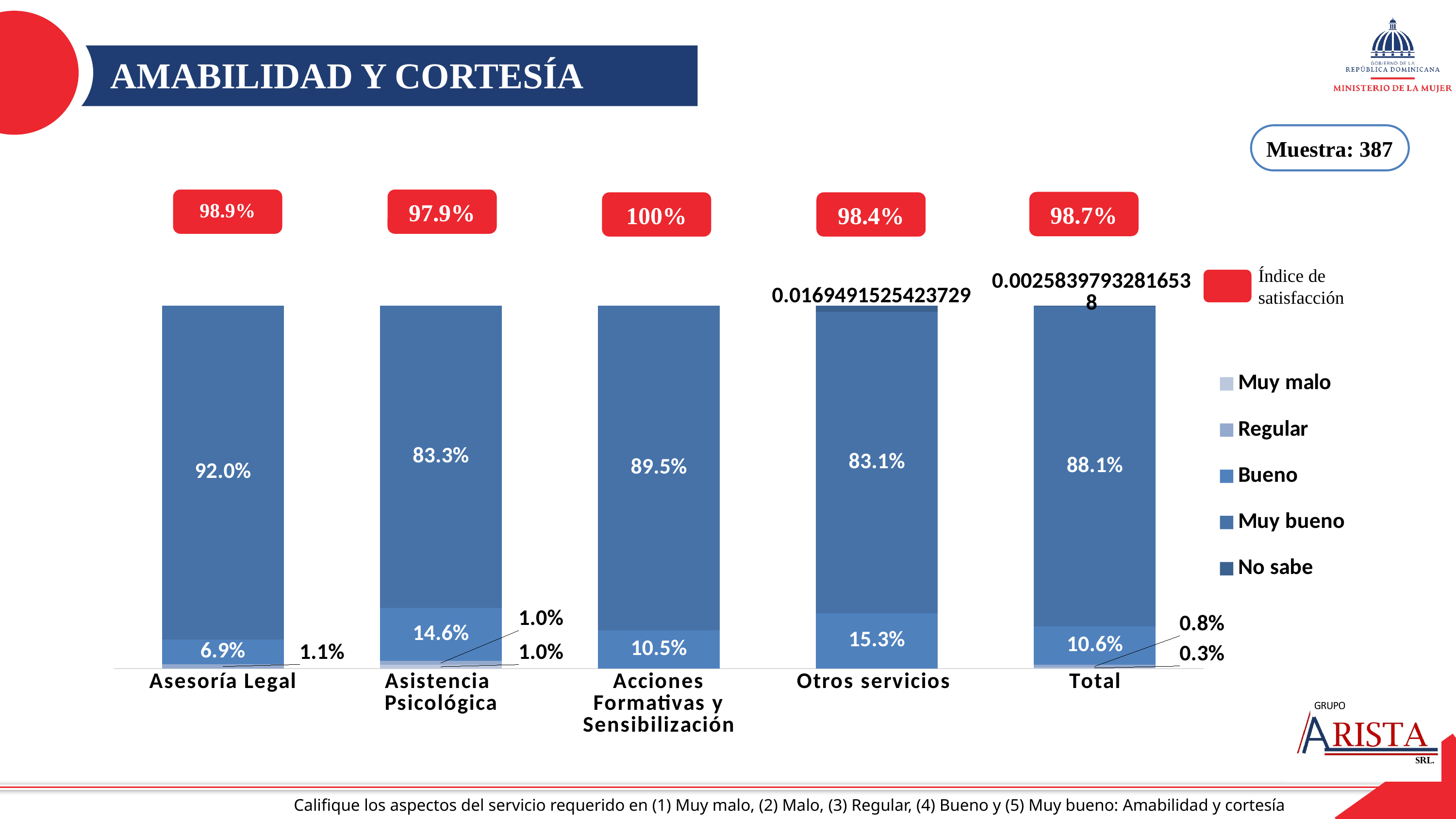
What sample size (Muestra) is shown on the slide? 387 What is the Índice de satisfacción shown for Acciones Formativas y Sensibilización? 100% Which is larger, the Bueno value for Asistencia Psicológica or for Acciones Formativas y Sensibilización? Asistencia Psicológica What is the Bueno value for Otros servicios? 15.3% How many series does the chart legend list (excluding the Índice de satisfacción marker)? 5 How many categories are shown along the x axis of the chart? 5 What is the difference between the Muy bueno values for Asesoría Legal and Total? 3.9% What type of chart is shown on the slide? stacked bar chart What is the Muy bueno value for Asesoría Legal? 92.0% Which category has the highest Muy bueno value? Asesoría Legal What is the Índice de satisfacción shown for Total? 98.7% Which category has the lowest Bueno value? Asesoría Legal